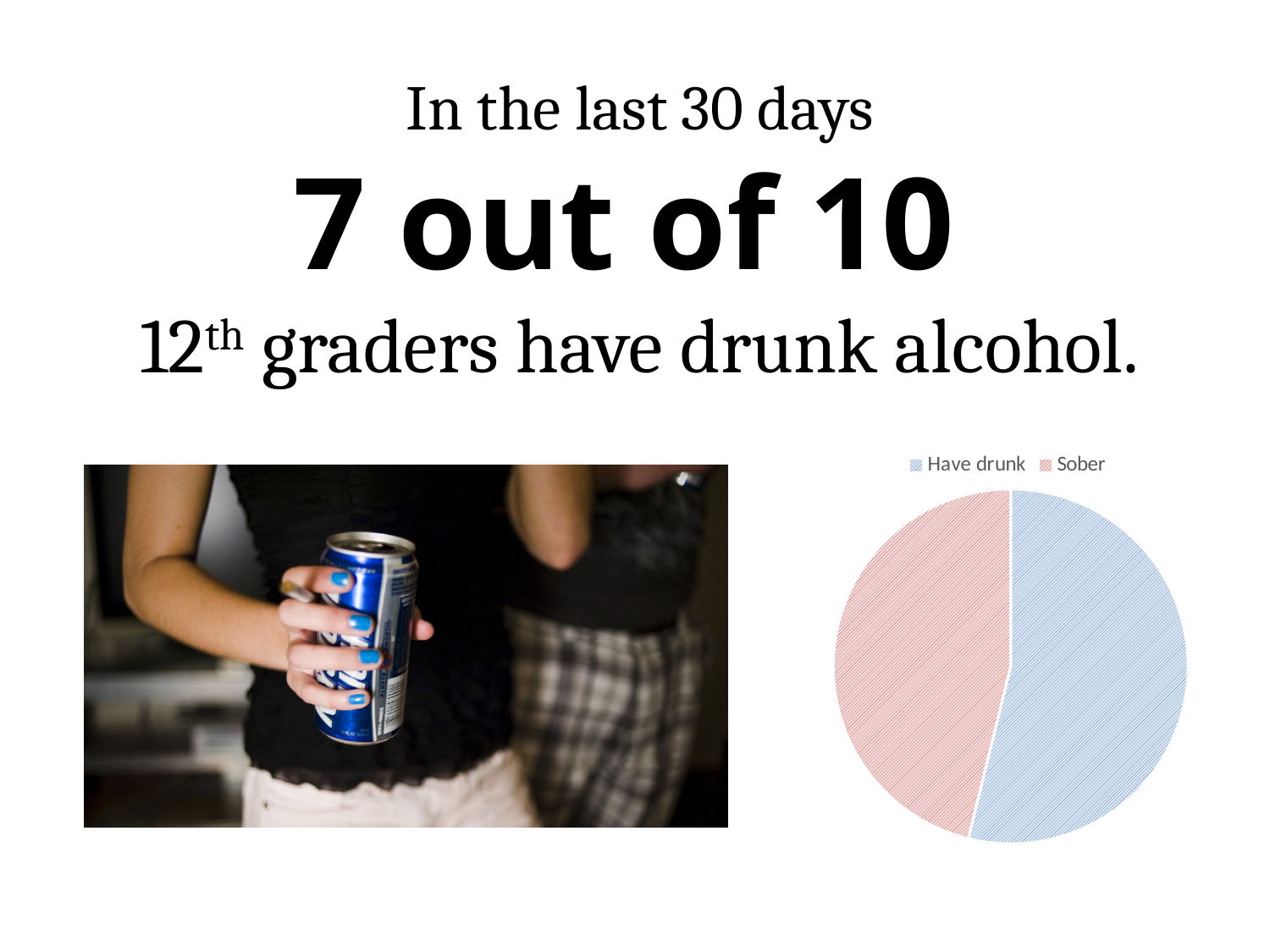
What kind of chart is shown on the slide? pie chart What are the two categories listed in the pie chart's legend? Have drunk, Sober Which category has the smallest slice in the pie chart? Sober How many entries does the legend of the pie chart list? 2 Which colour represents the "Have drunk" slice in the pie chart? blue Which category has the largest slice in the pie chart? Have drunk How many slices does the pie chart have? 2 Which slice of the pie chart is larger, "Have drunk" or "Sober"? Have drunk